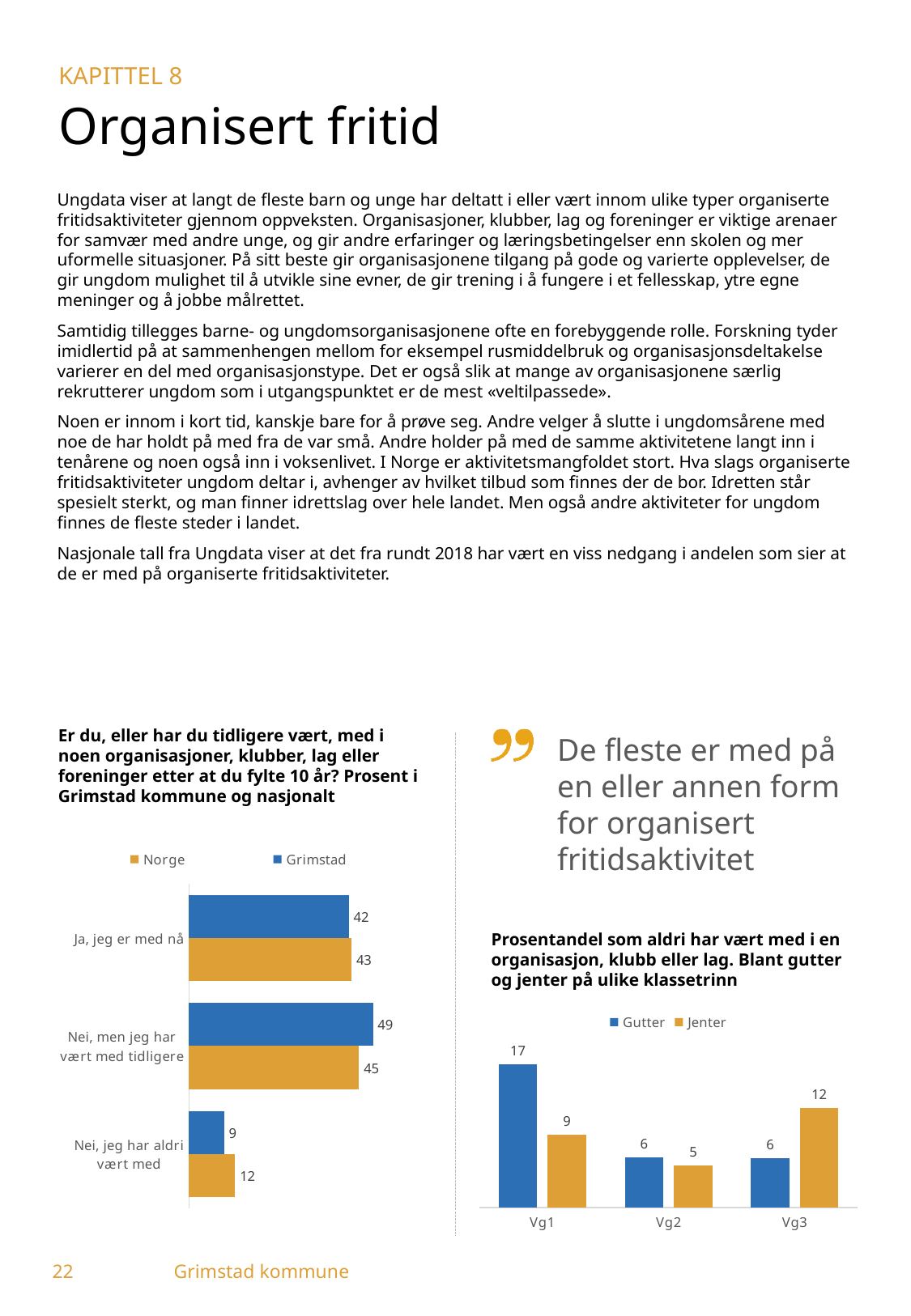
In the left chart (Er du, eller har du tidligere vært, med i noen organisasjoner...), which is larger for 'Ja, jeg er med nå': Norge or Grimstad? Norge In the right chart (Prosentandel som aldri har vært med i en organisasjon...), what is the Jenter value for Vg3? 12 In the right chart (Prosentandel som aldri har vært med i en organisasjon...), how many class levels are shown on the x axis? 3 In the right chart (Prosentandel som aldri har vært med i en organisasjon...), which class level has the lowest Jenter value? Vg2 In the left chart (Er du, eller har du tidligere vært, med i noen organisasjoner...), how many series does the legend list? 2 In the left chart (Er du, eller har du tidligere vært, med i noen organisasjoner...), what is the Grimstad value for 'Nei, men jeg har vært med tidligere'? 49 In the right chart (Prosentandel som aldri har vært med i en organisasjon...), what is the Gutter value for Vg1? 17 In the left chart (Er du, eller har du tidligere vært, med i noen organisasjoner...), what is the difference between the Grimstad and Norge values for 'Nei, men jeg har vært med tidligere'? 4 In the left chart (Er du, eller har du tidligere vært, med i noen organisasjoner...), which category has the highest Grimstad value? Nei, men jeg har vært med tidligere In the right chart (Prosentandel som aldri har vært med i en organisasjon...), what is the difference between Gutter and Jenter for Vg1? 8 In the left chart (Er du, eller har du tidligere vært, med i noen organisasjoner...), what is the Norge value for 'Nei, jeg har aldri vært med'? 12 What kind of chart is the left chart (Er du, eller har du tidligere vært, med i noen organisasjoner...)? Bar chart